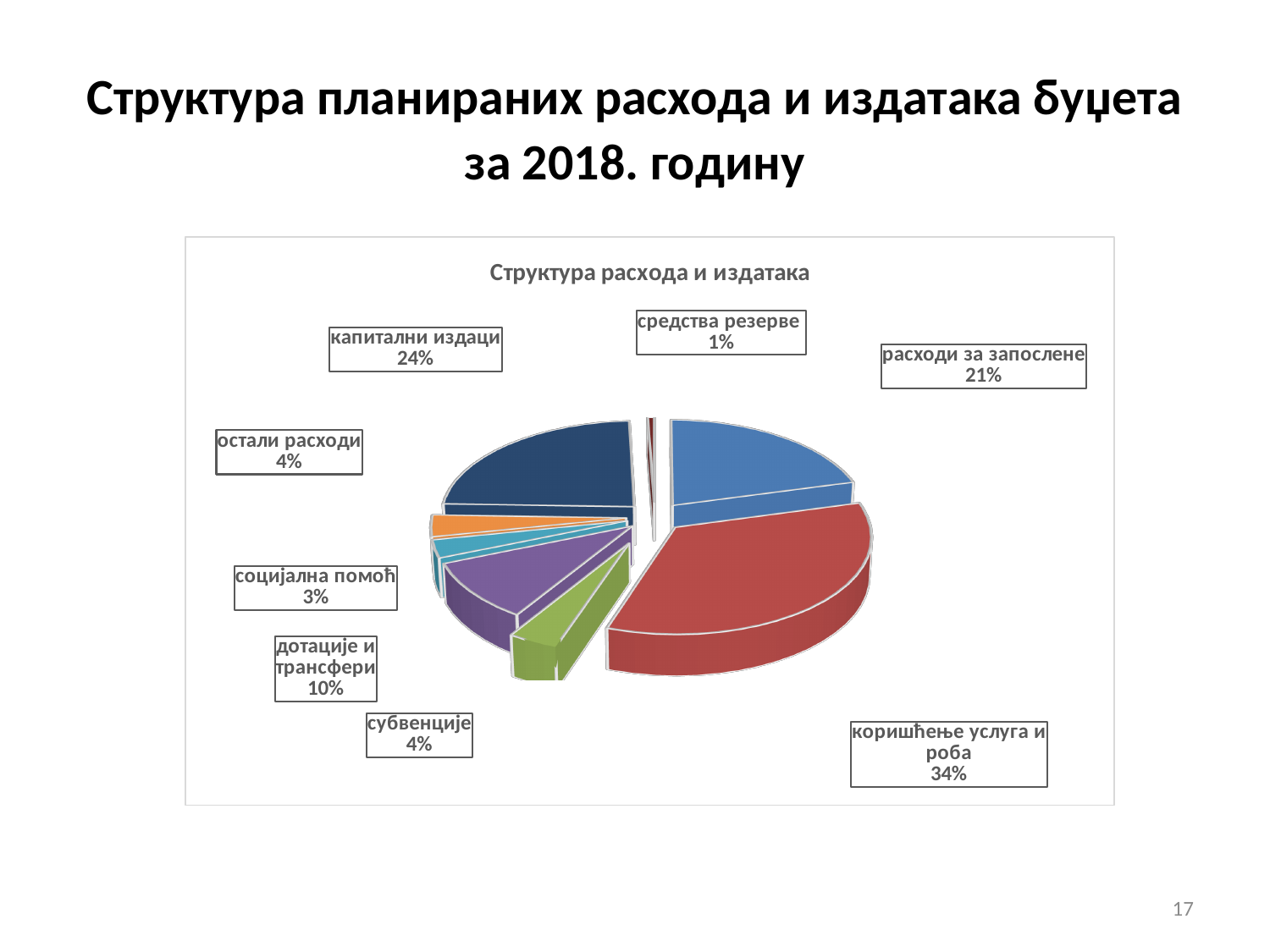
What percentage is shown for "капитални издаци"? 24% What percentage is shown for "социјална помоћ"? 3% How many categories (slices) does the pie chart have? 8 Which category has the smallest share of the pie? средства резерве What percentage is shown for "дотације и трансфери"? 10% What is the title of the chart? Структура расхода и издатака What percentage is shown for "расходи за запослене"? 21% What type of chart is shown on the slide? pie chart Which is larger: the share for "капитални издаци" or the share for "расходи за запослене"? капитални издаци What share of the pie is labelled "коришћење услуга и роба"? 34% Which category has the largest share of the pie? коришћење услуга и роба What is the difference in percentage points between "коришћење услуга и роба" and "расходи за запослене"? 13